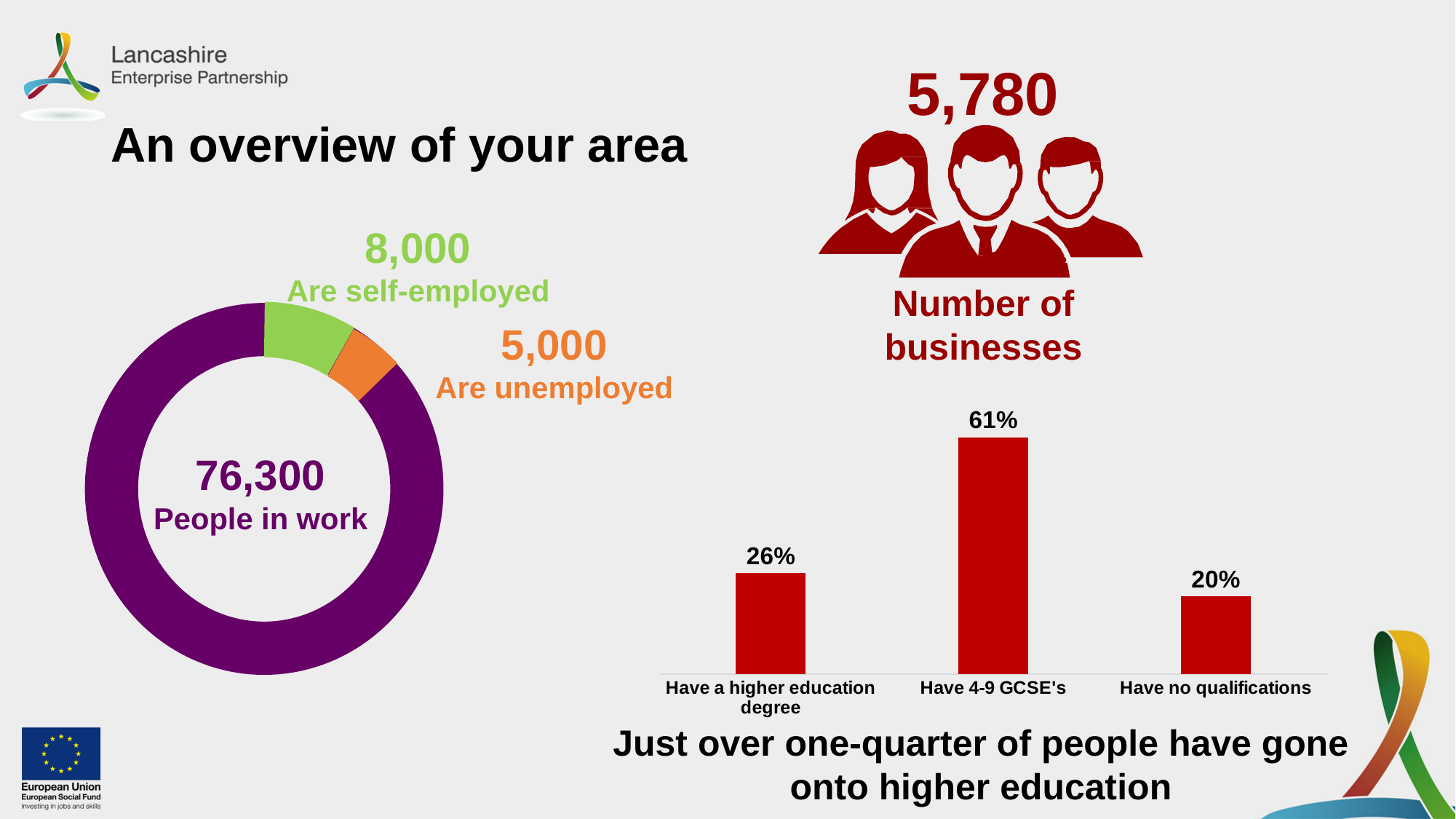
What kind of chart is the chart on the right of the slide? Bar chart In the bar chart on the right, which category has the lowest value? Have no qualifications In the bar chart on the right, what is the difference between the percentage with 4-9 GCSE's and the percentage with a higher education degree? 35% In the bar chart on the right, how many categories are shown? 3 In the donut chart on the left, what is the difference between the number self-employed and the number unemployed? 3,000 In the bar chart on the right, what percentage of people have a higher education degree? 26% In the donut chart on the left, which is larger: the number self-employed or the number unemployed? Self-employed In the bar chart on the right, what percentage of people have 4-9 GCSE's? 61% In the bar chart on the right, which category has the highest value? Have 4-9 GCSE's In the donut chart on the left, how many people are self-employed? 8,000 In the bar chart on the right, what percentage of people have no qualifications? 20% In the donut chart on the left, how many people are in work? 76,300